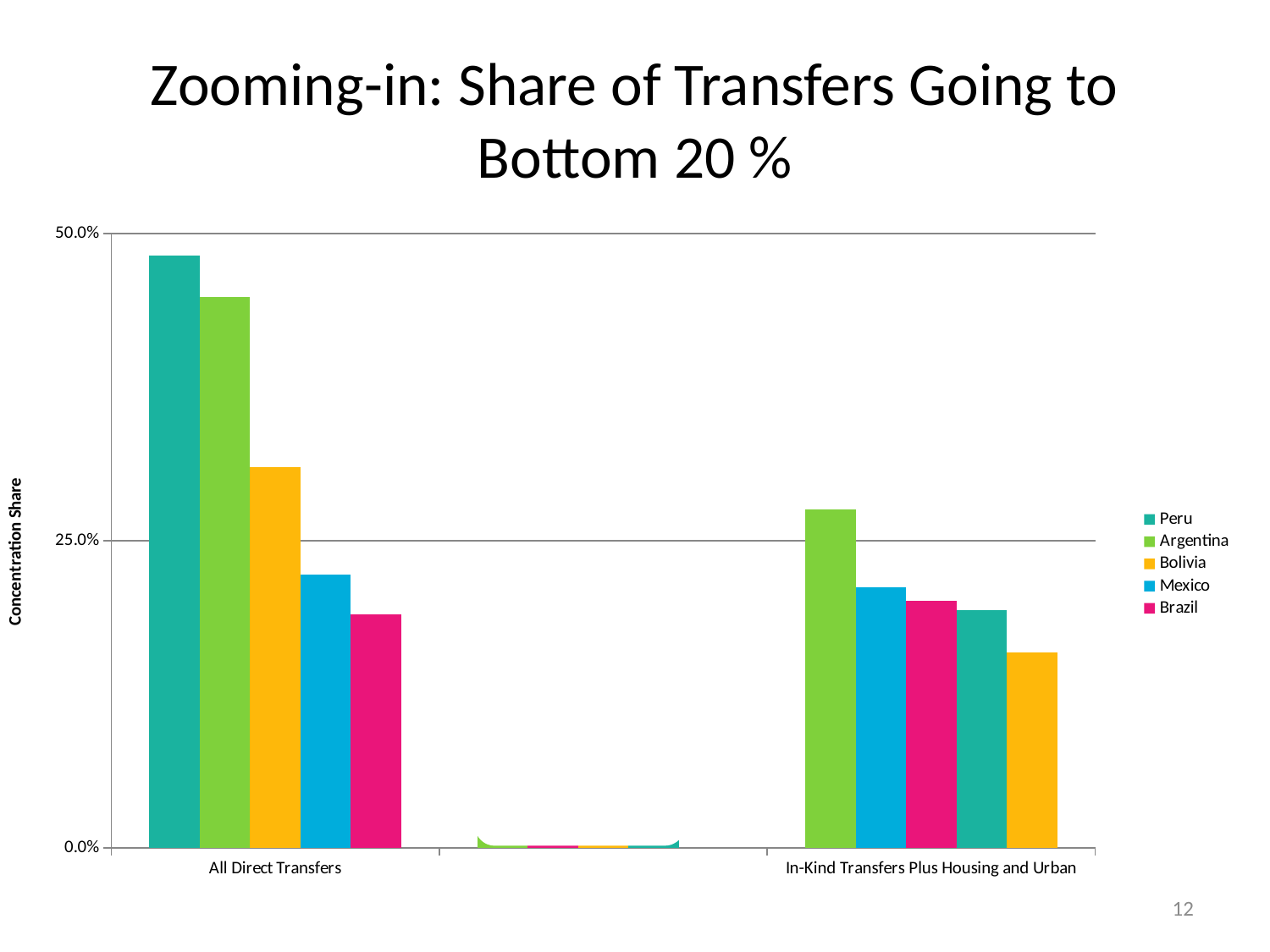
Which country has the lowest bar for In-Kind Transfers Plus Housing and Urban? Bolivia Is the value for Bolivia under All Direct Transfers greater or less than 25.0%? greater How many series does the legend list? 5 Is the value for Argentina under In-Kind Transfers Plus Housing and Urban greater or less than 25.0%? greater What is the title of the vertical axis? Concentration Share What kind of chart is shown on the slide? bar chart Which country has the highest bar for In-Kind Transfers Plus Housing and Urban? Argentina Which country has the lowest bar for All Direct Transfers? Brazil Which country has the highest bar for All Direct Transfers? Peru For In-Kind Transfers Plus Housing and Urban, which is larger: the value for Peru or the value for Bolivia? Peru For All Direct Transfers, which is larger: the value for Peru or the value for Argentina? Peru Is the value for Mexico under All Direct Transfers greater or less than 25.0%? less